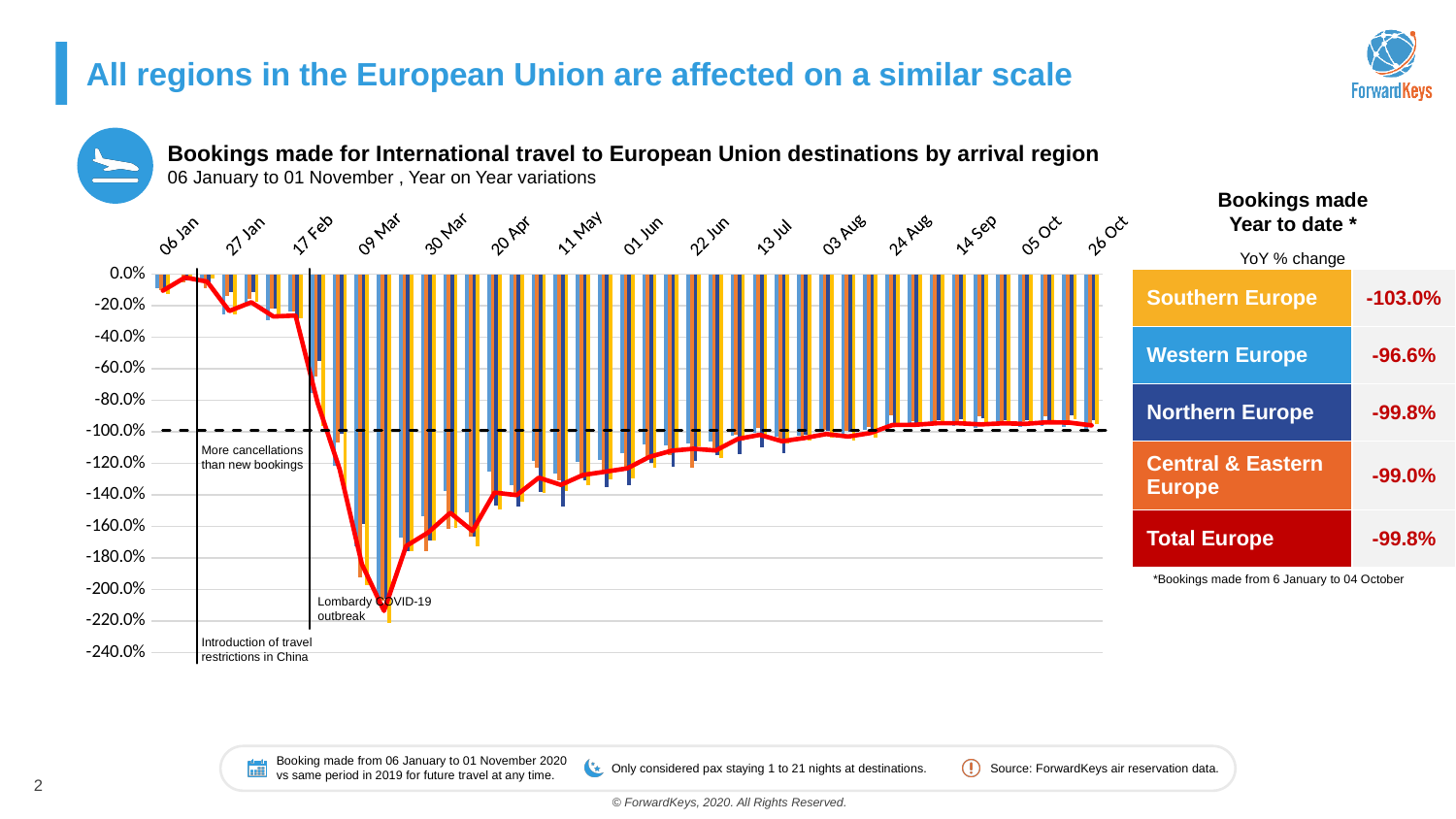
Does the red line on the bookings chart rise or fall between 09 Mar and 26 Oct? rise What kind of chart is used to show the year-on-year variations in bookings to European Union destinations? A bar chart combined with a line Is the value of the red line at 26 Oct greater or less than -80.0%? less How many date labels are shown along the x axis of the bookings chart? 15 Is the value of the red line at 06 Jan greater or less than -20.0%? greater In the 'Bookings made Year to date' table, what is the YoY % change for Western Europe? -96.6% Is the lowest point of the red line on the bookings chart greater or less than -200.0%? less At which y-axis level is the horizontal dashed line drawn on the bookings chart? -100.0% What is the lowest value shown on the y axis of the bookings chart? -240.0% In the 'Bookings made Year to date' table, what is the difference between the YoY % change for Western Europe and Southern Europe? 6.4 percentage points In the 'Bookings made Year to date' table, which region has the lowest YoY % change? Southern Europe In the 'Bookings made Year to date' table, what is the YoY % change for Southern Europe? -103.0%